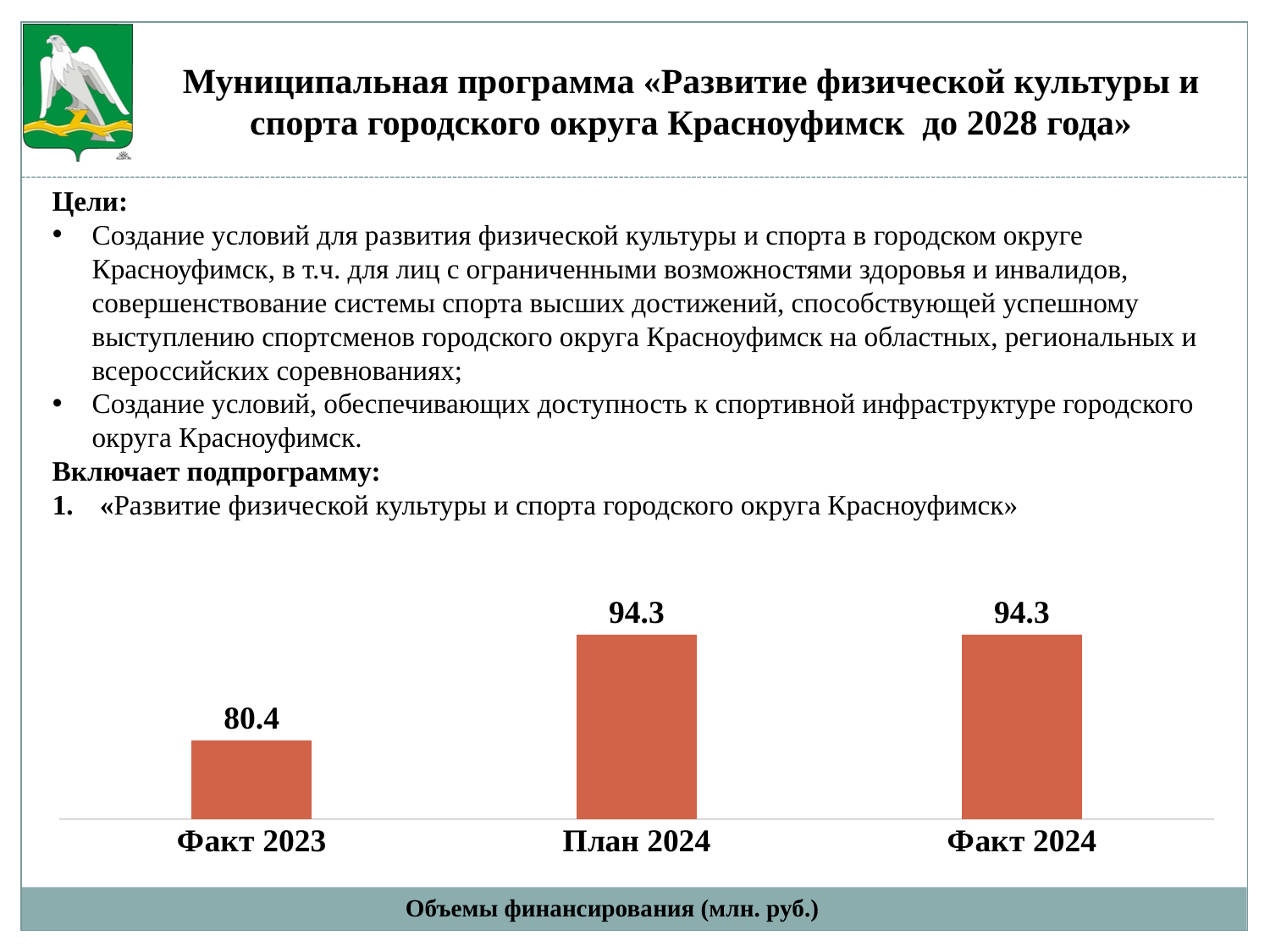
What is the caption printed below the chart? Объемы финансирования (млн. руб.) Does the value rise or fall from Факт 2023 to План 2024? rise What is the difference between the values for План 2024 and Факт 2023? 13.9 What unit of measurement is given in the caption below the chart? млн. руб. Which category has the lowest value? Факт 2023 What is the value for План 2024? 94.3 How many categories are shown on the chart? 3 Which is larger, the value for Факт 2023 or the value for План 2024? План 2024 What is the value for Факт 2024? 94.3 What is the value for Факт 2023? 80.4 Is the value for Факт 2024 higher than, lower than, or the same as the value for План 2024? the same What kind of chart is shown on the slide? bar chart